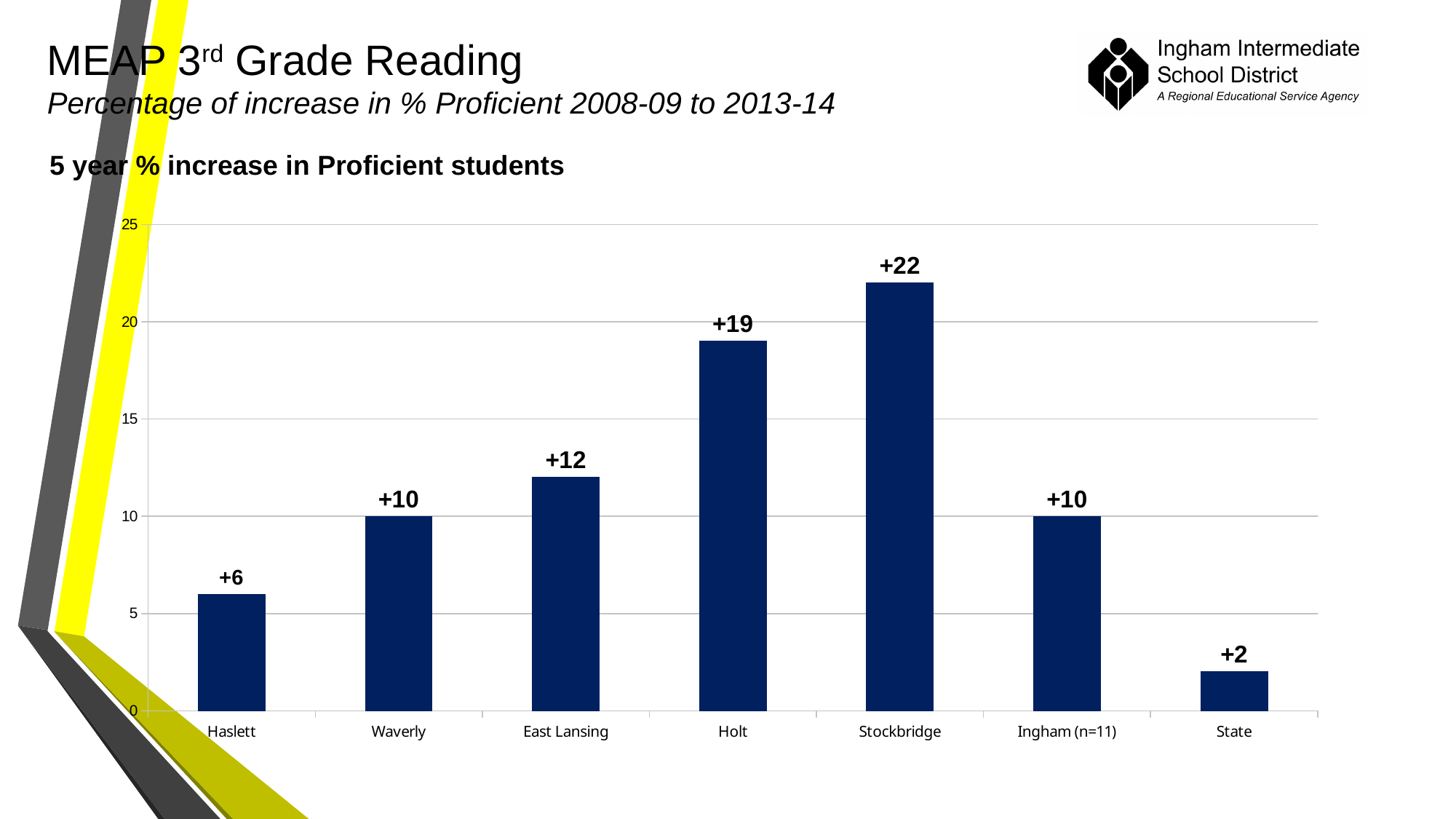
What is the value shown for Holt? +19 Which category has the highest value? Stockbridge What is the value shown for Haslett? +6 Which category has the lowest value? State How many categories are shown on the x axis? 7 What is the value shown for Ingham (n=11)? +10 Which is larger, the value for Waverly or the value for East Lansing? East Lansing What is the value shown for State? +2 What is the difference between the values for Stockbridge and Holt? 3 Is the value for Holt greater or less than 15? greater What kind of chart is shown on the slide? bar chart What is the difference between the values for East Lansing and Haslett? 6